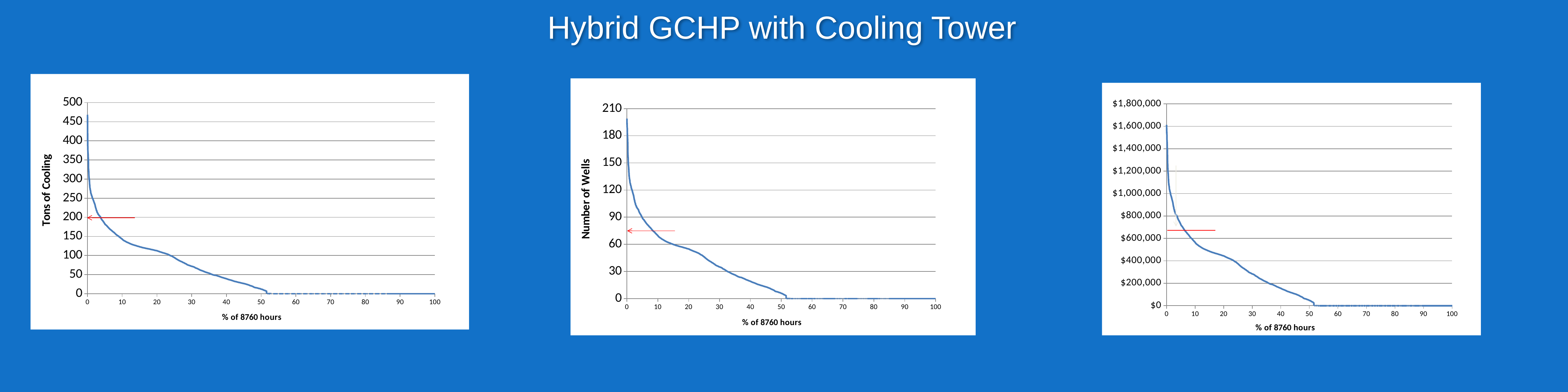
In the middle chart (Number of Wells), is the value at 0% of 8760 hours greater or less than 180? greater What is the y-axis title of the left chart? Tons of Cooling How many charts are shown on the slide? 3 In the right chart (dollar values), is the value at 0% of 8760 hours greater or less than $1,400,000? greater In the left chart (Tons of Cooling), is the value at 0% of 8760 hours greater or less than 400? greater In the middle chart (Number of Wells), do the values rise or fall along the x axis? fall What kind of chart is the left chart (Tons of Cooling)? line chart What is the x-axis title of the middle chart? % of 8760 hours In the left chart (Tons of Cooling), do the values rise or fall as % of 8760 hours increases? fall